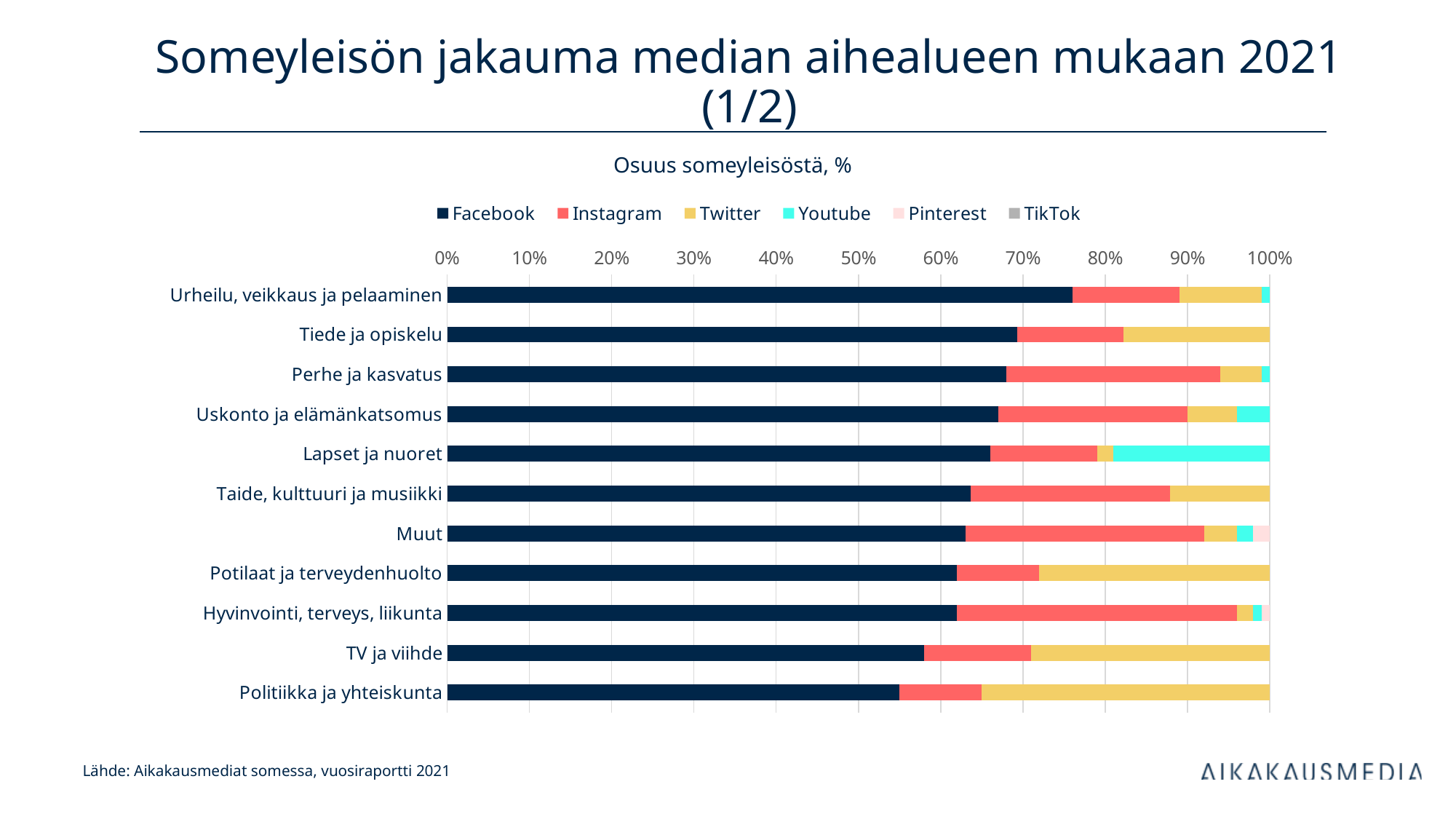
Is the Facebook share for Urheilu, veikkaus ja pelaaminen greater or less than 70%? greater Which category has the largest Facebook share? Urheilu, veikkaus ja pelaaminen Which has the larger Twitter share: Politiikka ja yhteiskunta or TV ja viihde? Politiikka ja yhteiskunta Which category has the largest Youtube share? Lapset ja nuoret Is the Facebook share for Politiikka ja yhteiskunta greater or less than 60%? less Does the Facebook share rise or fall going from the top category to the bottom category? fall Which series is shown in dark navy blue in the legend? Facebook How many categories (media topic areas) are plotted on the chart? 11 Is the Facebook share for Tiede ja opiskelu greater or less than 60%? greater What kind of chart is shown on the slide? Stacked bar chart How many series does the legend list? 6 Which category has the smallest Facebook share? Politiikka ja yhteiskunta